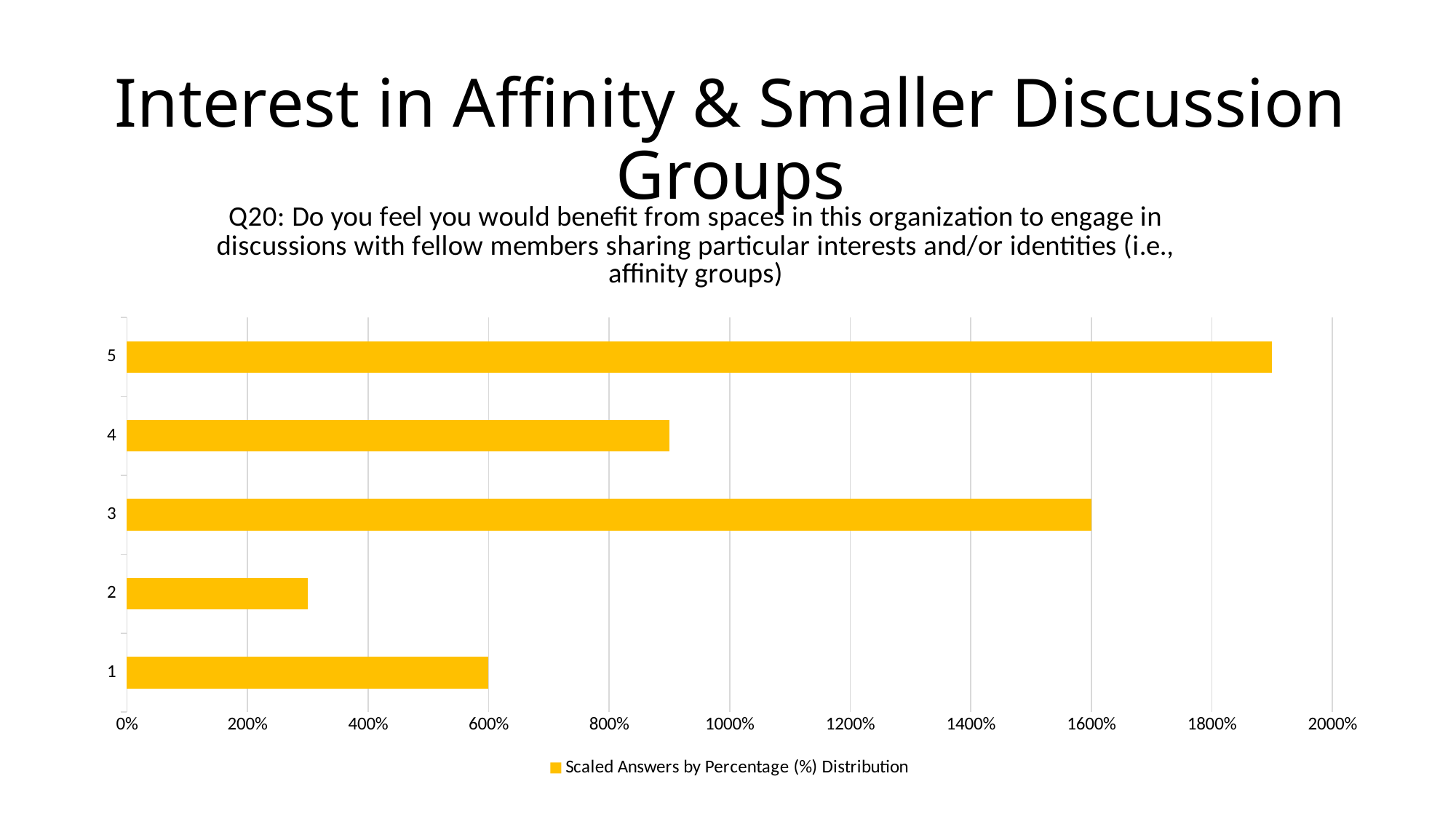
What is the difference between the values for category 3 and category 1? 1000% What is the value for category 1? 600% How many series does the legend list? 1 Which category has the highest value? 5 How many categories are shown on the chart? 5 Is the value for category 2 greater or less than 400%? less Is the value for category 5 greater or less than 1800%? greater Is the value for category 4 greater or less than 800%? greater Which category has the lowest value? 2 What kind of chart is shown on the slide? Bar chart Which has the larger value, category 3 or category 4? 3 What is the value for category 3? 1600%